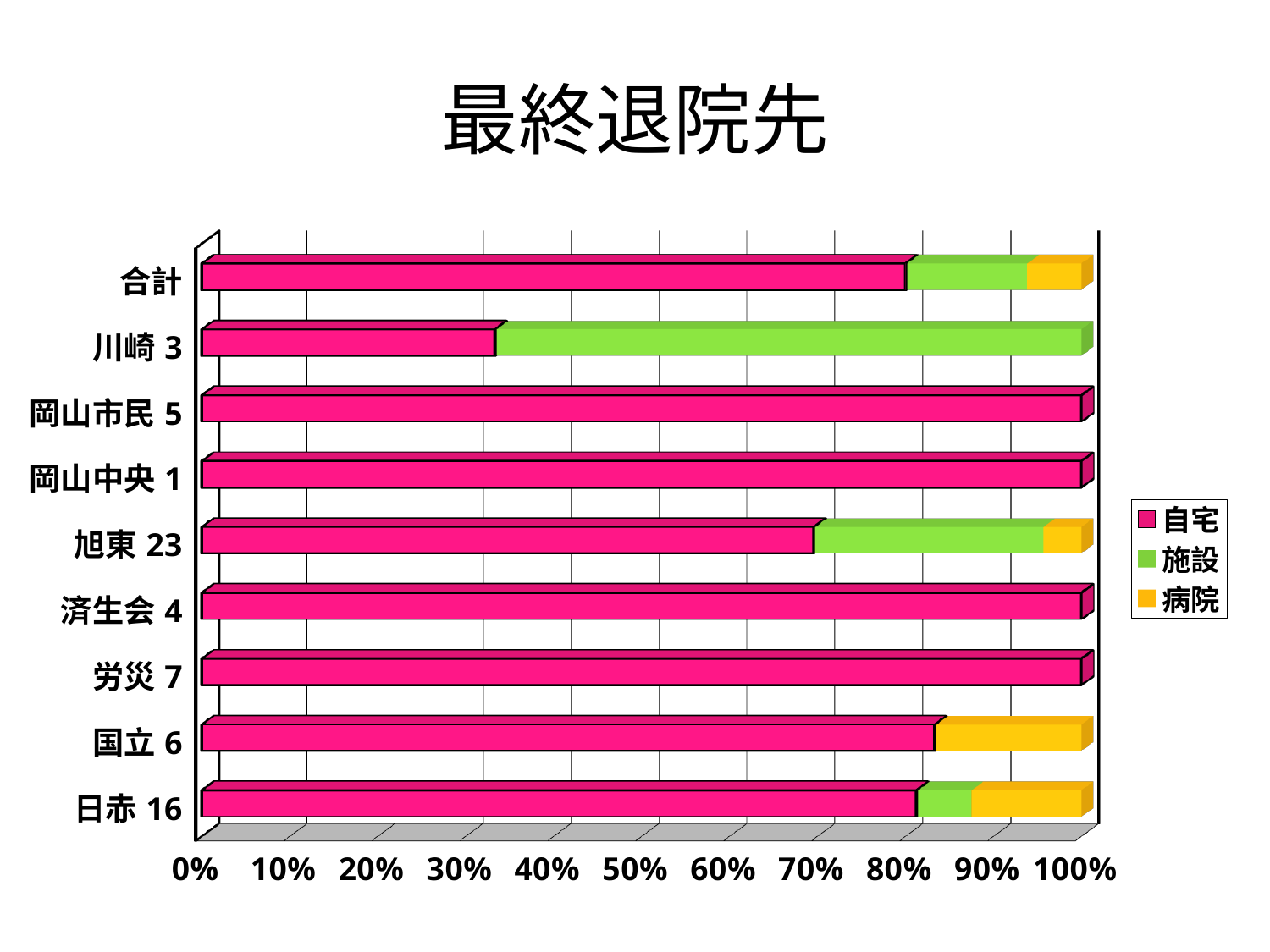
Which legend entry is shown in yellow? 病院 What kind of chart is shown on the slide? bar chart Which category has the lowest share for 自宅? 川崎 3 Is the 自宅 share for 川崎 3 greater or less than 40%? less How many categories are shown on the vertical axis of the chart? 9 Which has a larger 自宅 share, 川崎 3 or 国立 6? 国立 6 What is the title of the chart? 最終退院先 Is the 施設 share for 川崎 3 greater or less than 60%? greater How many series does the legend list? 3 Is the 自宅 share for 国立 6 greater or less than 80%? greater Which has a larger 自宅 share, 旭東 23 or 労災 7? 労災 7